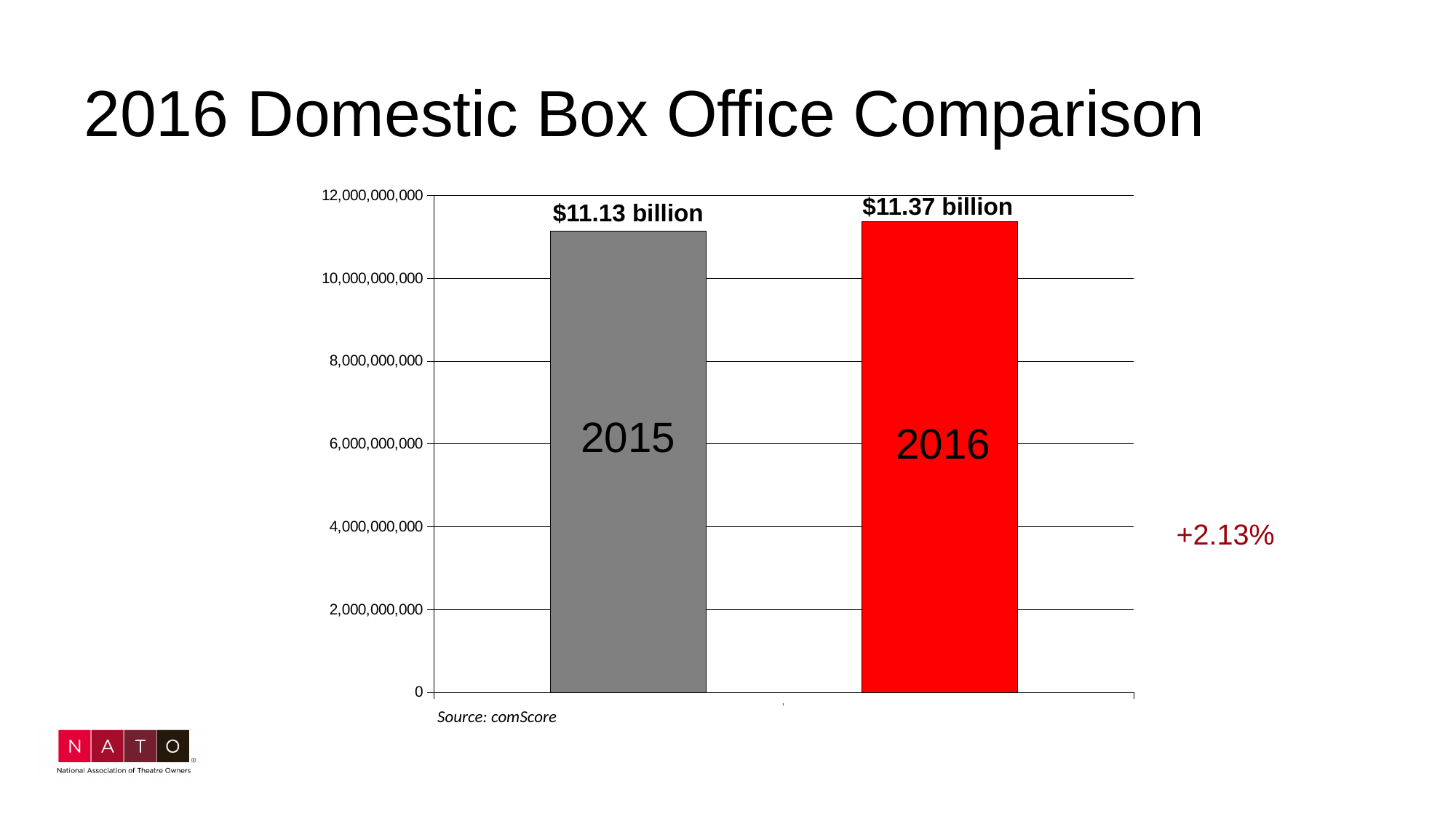
What is the domestic box office value shown for 2016? $11.37 billion What kind of chart is shown on the slide? bar chart Is the value for 2016 greater or less than 12,000,000,000? less Is the 2016 domestic box office value larger or smaller than the 2015 value? larger What colour is the bar for 2016? red What percentage change is shown next to the chart? +2.13% What is the difference between the 2016 and 2015 domestic box office values? $0.24 billion What is the domestic box office value shown for 2015? $11.13 billion Is the value for 2015 greater or less than 10,000,000,000? greater Which year has the higher domestic box office value? 2016 How many bars are shown in the chart? 2 Which year has the lower domestic box office value? 2015